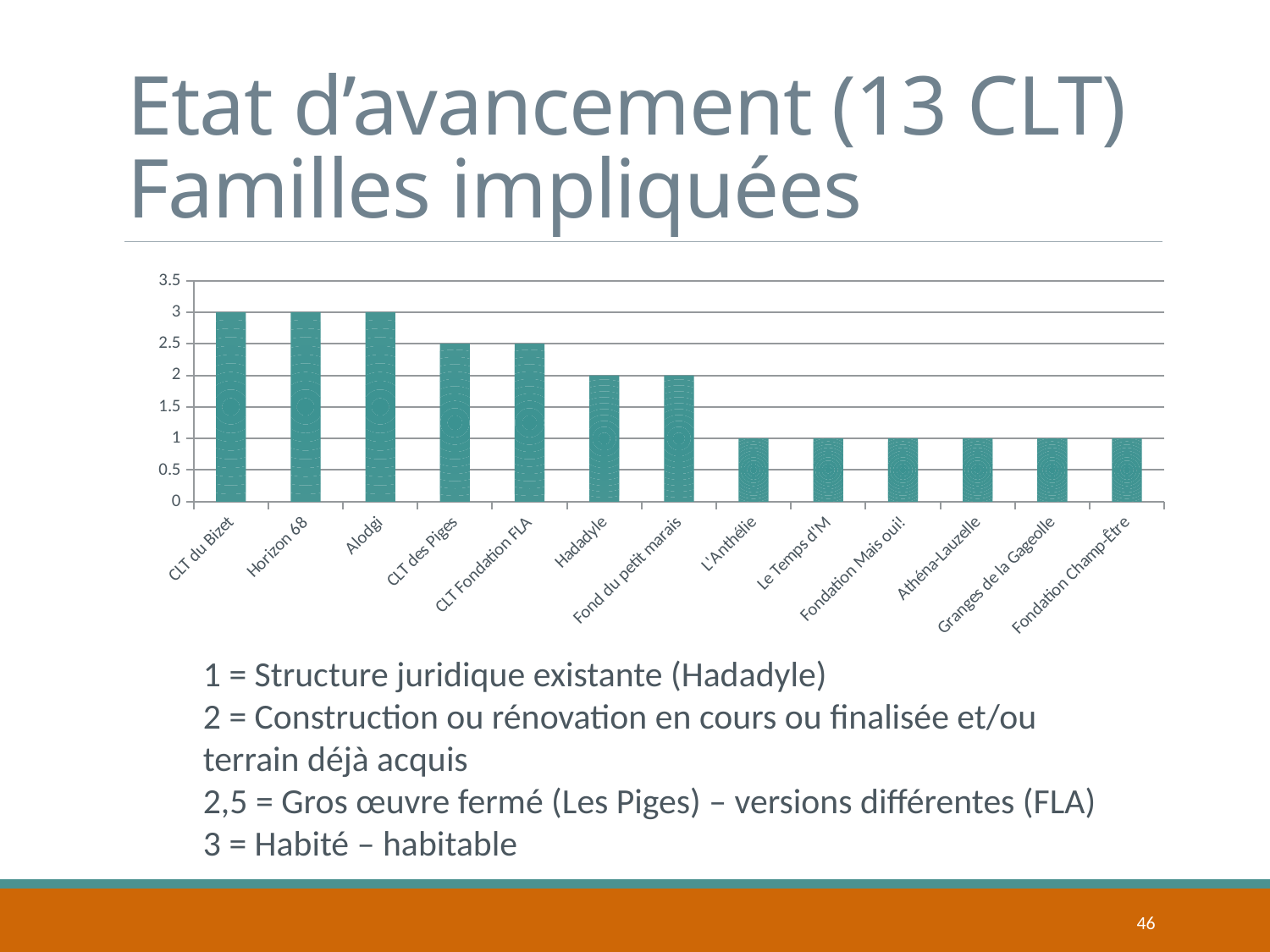
What is the value for Hadadyle? 2 What kind of chart is shown on the slide? bar chart How many categories (CLTs) are plotted on the chart? 13 Is the value for CLT Fondation FLA greater or less than 2? greater What is the highest value shown on the vertical axis? 3.5 Which has a larger value, Alodgi or Le Temps d'M? Alodgi What is the difference between the values for CLT du Bizet and Fond du petit marais? 1 What is the value for Athéna-Lauzelle? 1 What is the value for CLT des Piges? 2.5 How many categories have a value of 3? 3 What is the value for Horizon 68? 3 Do the values generally rise or fall from left to right along the x axis? fall